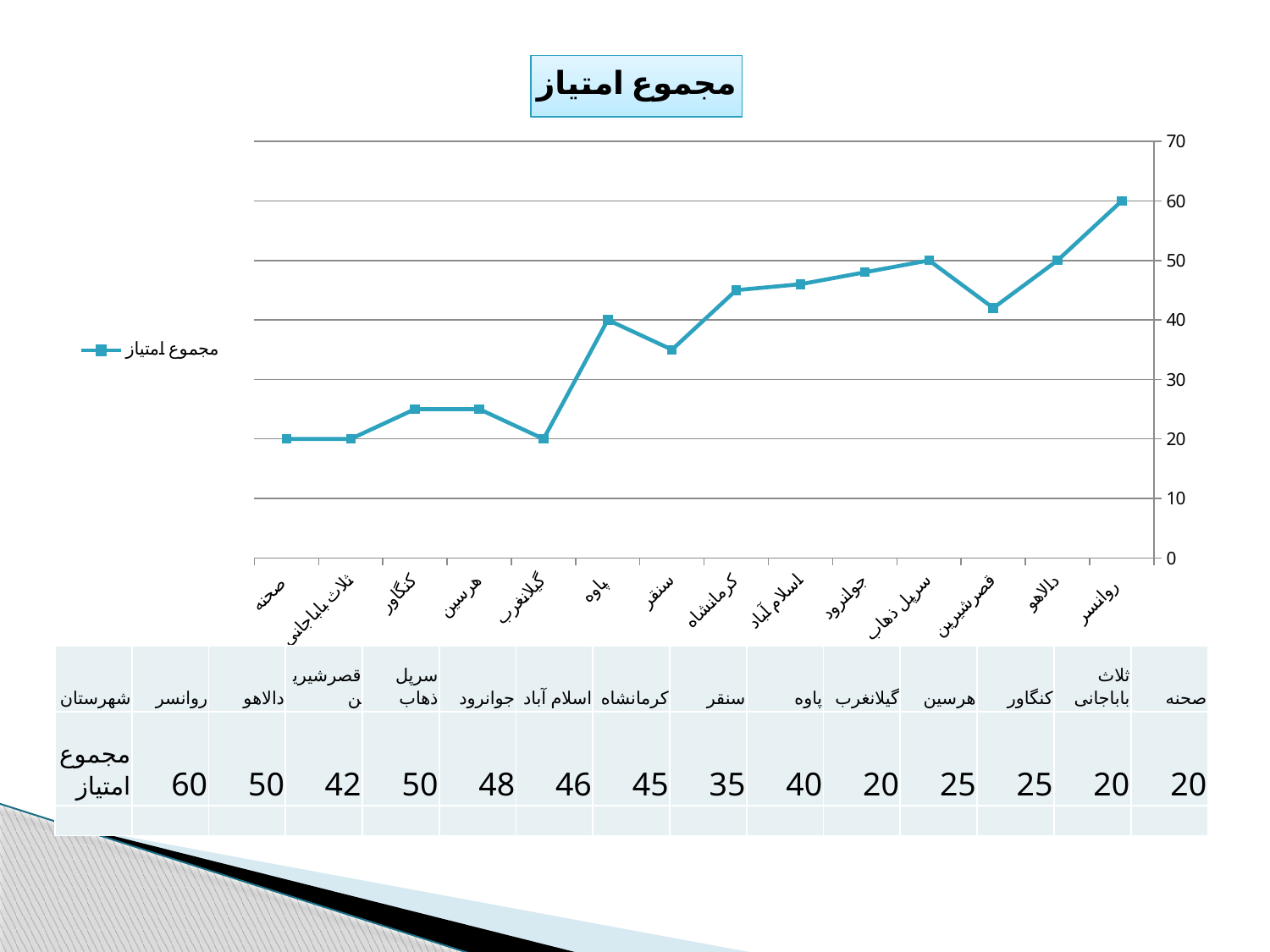
What is the difference between the values for روانسر and سنقر? 25 How many categories (cities) are plotted on the x axis? 14 What is the value for روانسر? 60 What is the value for قصرشیرین? 42 Is the value for جوانرود greater or less than 40? greater Do the values generally rise or fall from صحنه on the left to روانسر on the right? rise Which is larger, the value for کرمانشاه or the value for سنقر? کرمانشاه How many series does the legend list? 1 What is the value for پاوه? 40 What is the title of the chart? مجموع امتیاز Which city has the highest value? روانسر What type of chart is shown on the slide? line chart